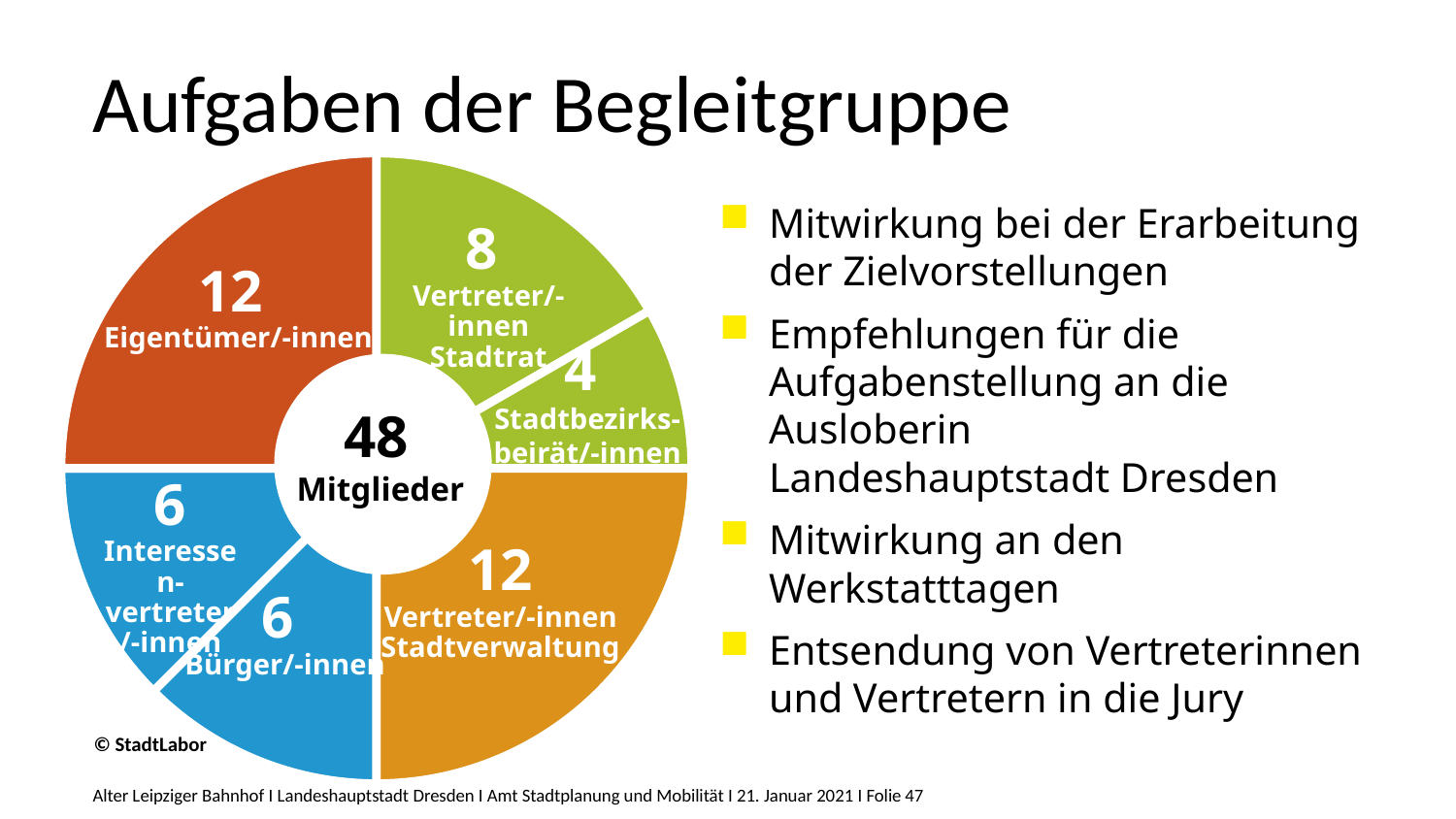
How many segments does the donut chart have? 6 How many Bürger/-innen are shown in the chart? 6 What kind of chart is shown on the slide? Donut (pie) chart What colour is the Eigentümer/-innen segment? Red-orange What is the difference between the number of Eigentümer/-innen and the number of Stadtbezirksbeirät/-innen? 8 Which is larger: Vertreter/-innen Stadtrat or Bürger/-innen? Vertreter/-innen Stadtrat What value is shown for Stadtbezirksbeirät/-innen? 4 What share of the 48 Mitglieder are Vertreter/-innen Stadtverwaltung? 25% Which group has the smallest segment in the chart? Stadtbezirksbeirät/-innen How many Vertreter/-innen Stadtrat does the chart show? 8 What is the total number of Mitglieder shown in the centre of the chart? 48 Mitglieder How many Eigentümer/-innen are in the Begleitgruppe according to the chart? 12